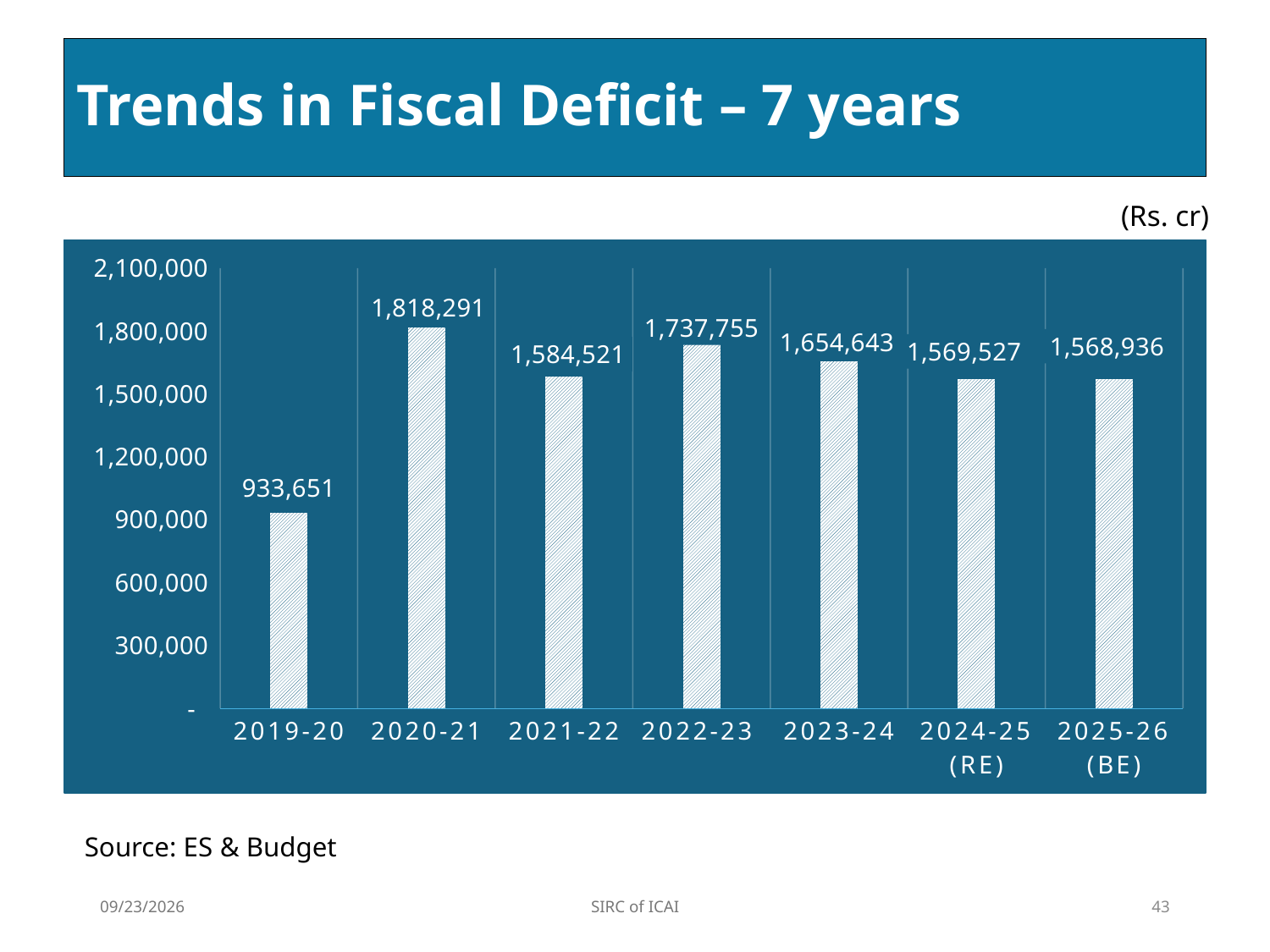
How many years are shown on the x axis of the chart? 7 What is the fiscal deficit value shown for 2019-20? 933,651 Which year has the highest fiscal deficit in the chart? 2020-21 Which year has the lowest fiscal deficit in the chart? 2019-20 What kind of chart is shown on the slide? bar chart Is the value for 2019-20 greater or less than 1,200,000? less What is the value shown for 2022-23? 1,737,755 What is the value shown for 2025-26 (BE)? 1,568,936 What is the difference between the values for 2020-21 and 2019-20? 884,640 Which is larger, the value for 2021-22 or the value for 2023-24? 2023-24 What is the difference between the values for 2022-23 and 2021-22? 153,234 What is the difference between the values for 2024-25 (RE) and 2025-26 (BE)? 591